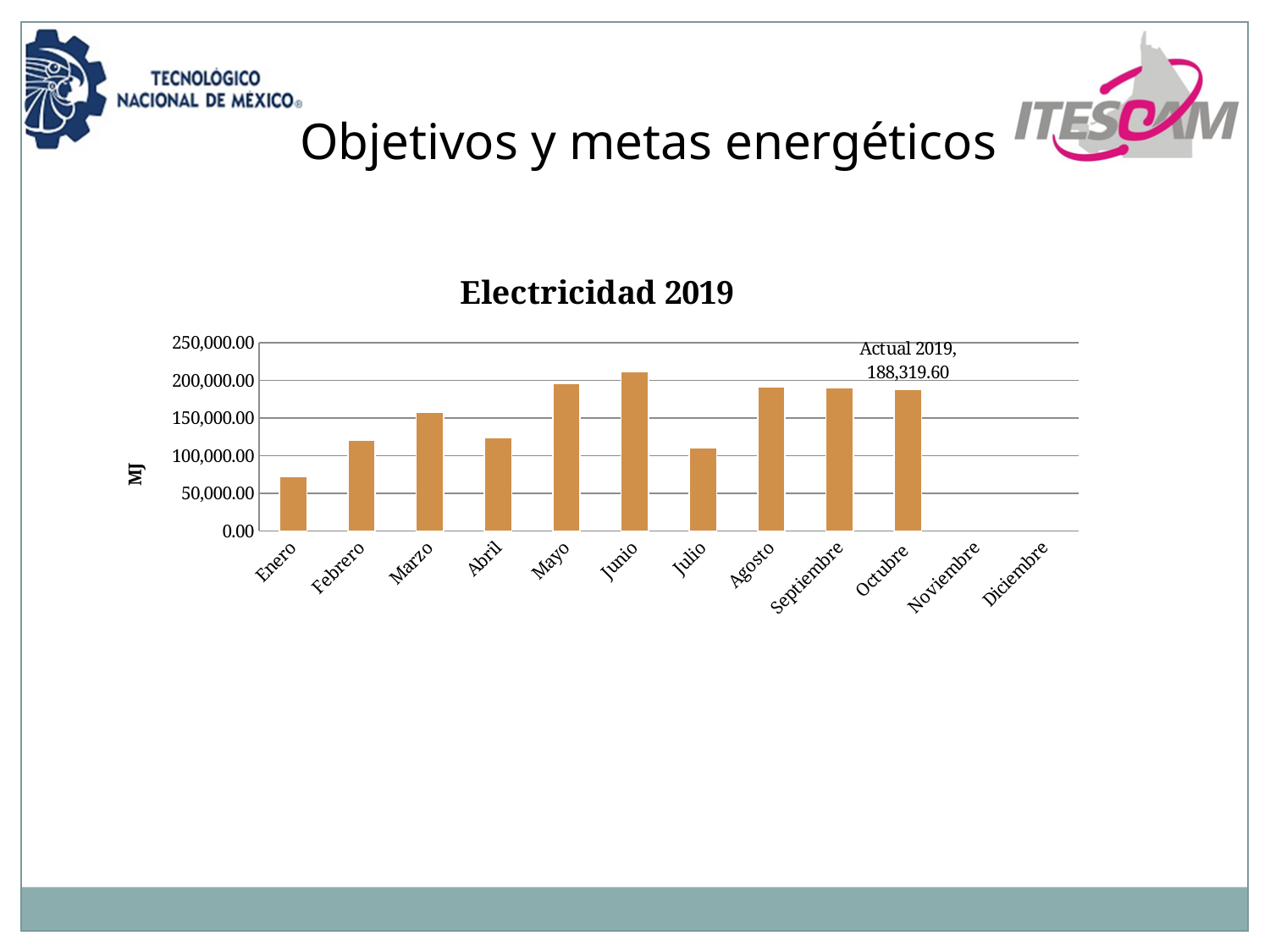
Among the months with a plotted bar, which has the lowest value? Enero What is the title of the chart? Electricidad 2019 How many months are listed on the x axis of the chart? 12 Is the value for Junio greater or less than 200,000.00? greater Which is larger, the value for Febrero or the value for Julio? Febrero Is the value for Abril greater or less than 150,000.00? less Which month has the highest electricity value in the chart? Junio What unit is shown on the y axis of the chart? MJ Which is larger, the value for Mayo or the value for Abril? Mayo What type of chart is shown on the slide? bar chart Is the value for Enero greater or less than 100,000.00? less What is the value shown for Octubre in the Electricidad 2019 chart? 188,319.60